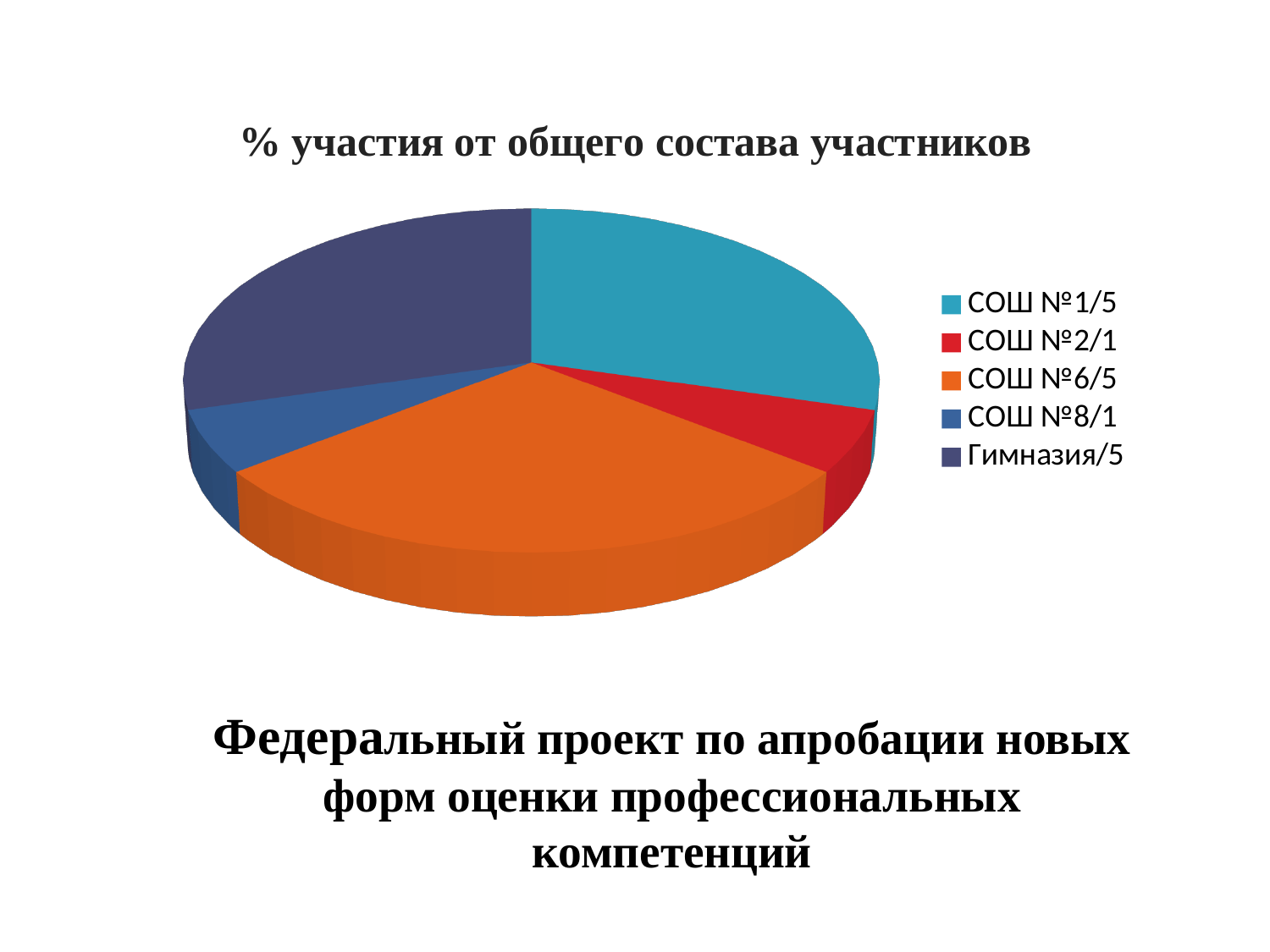
Which slice is larger: СОШ №1/5 or СОШ №2/1? СОШ №1/5 Which slice is larger: СОШ №8/1 or Гимназия/5? Гимназия/5 How many categories (slices) does the pie chart have? 5 Which slice is larger: СОШ №6/5 or СОШ №8/1? СОШ №6/5 How many entries does the legend of the pie chart list? 5 What is the title of the pie chart? % участия от общего состава участников What kind of chart is shown on the slide? pie chart What colour is the slice for СОШ №6/5 in the pie chart? orange